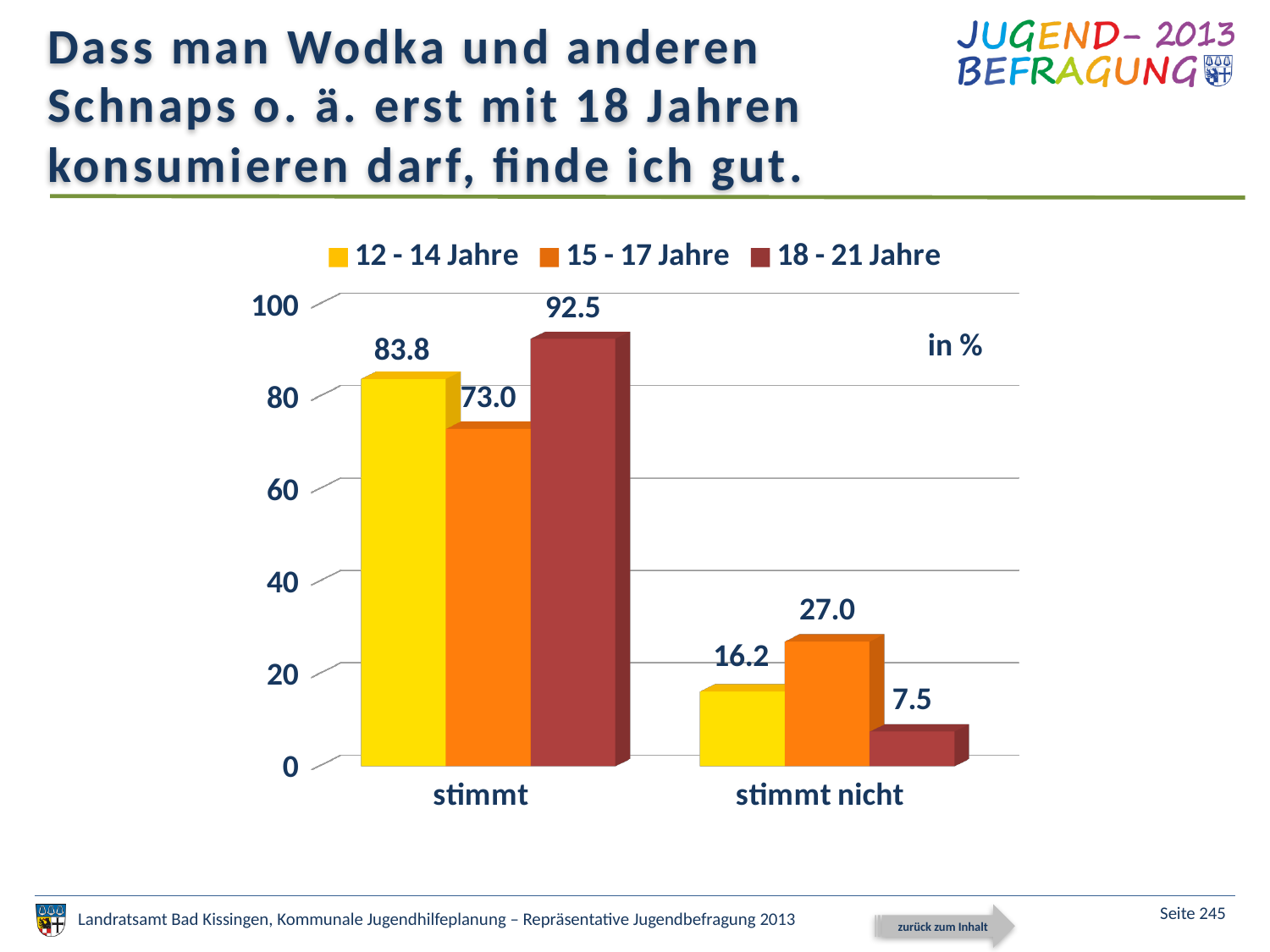
What is the value for the 18 - 21 Jahre series in the "stimmt" category? 92.5 Is the value for 15 - 17 Jahre in the "stimmt" category greater or less than 80? less What is the difference between the 15 - 17 Jahre and 18 - 21 Jahre values in the "stimmt nicht" category? 19.5 Which age group has the lowest value in the "stimmt nicht" category? 18 - 21 Jahre What is the difference between the 18 - 21 Jahre and 12 - 14 Jahre values in the "stimmt" category? 8.7 Which is larger: the 12 - 14 Jahre value for "stimmt nicht" or the 15 - 17 Jahre value for "stimmt nicht"? 15 - 17 Jahre What is the value for the 15 - 17 Jahre series in the "stimmt" category? 73.0 What kind of chart is shown on the slide? bar chart What is the value for the 12 - 14 Jahre series in the "stimmt nicht" category? 16.2 How many series does the legend list? 3 Which age group has the highest value in the "stimmt" category? 18 - 21 Jahre How many categories are shown on the x axis? 2